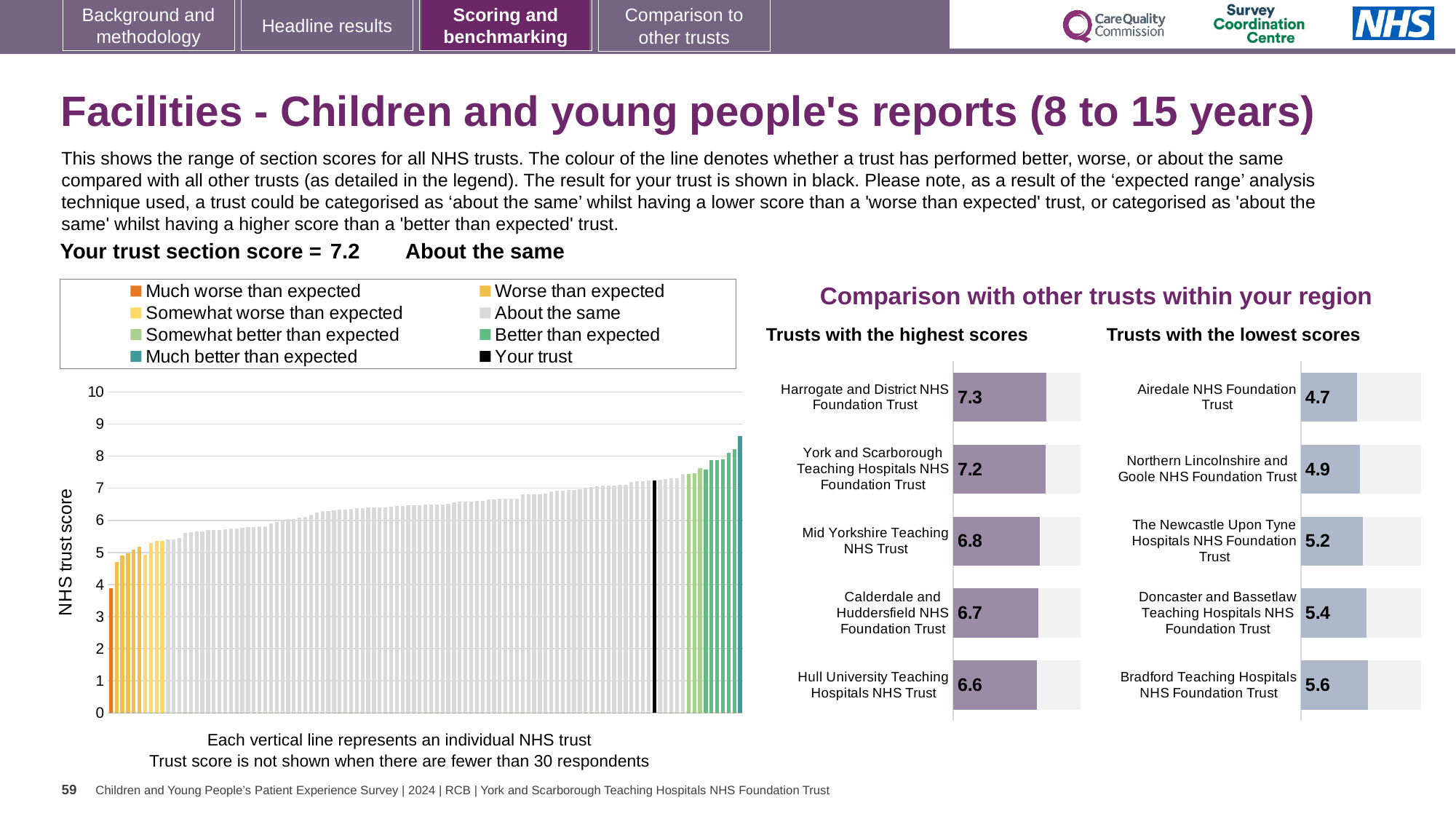
In the 'Trusts with the highest scores' chart, what is the score for Harrogate and District NHS Foundation Trust? 7.3 In the 'Trusts with the lowest scores' chart, what is the score for Airedale NHS Foundation Trust? 4.7 In the large chart on the left showing the range of section scores, do the bar values rise or fall from left to right? rise In the 'Trusts with the lowest scores' chart, what is the score for Doncaster and Bassetlaw Teaching Hospitals NHS Foundation Trust? 5.4 In the 'Trusts with the highest scores' chart, which trust has the lowest score? Hull University Teaching Hospitals NHS Trust In the 'Trusts with the highest scores' chart, what is the score for Mid Yorkshire Teaching NHS Trust? 6.8 In the 'Trusts with the highest scores' chart, what is the difference between the scores of Harrogate and District NHS Foundation Trust and Hull University Teaching Hospitals NHS Trust? 0.7 How many trusts are shown in the 'Trusts with the lowest scores' chart? 5 Which has a higher score: Northern Lincolnshire and Goole NHS Foundation Trust in the 'Trusts with the lowest scores' chart, or Calderdale and Huddersfield NHS Foundation Trust in the 'Trusts with the highest scores' chart? Calderdale and Huddersfield NHS Foundation Trust In the 'Trusts with the lowest scores' chart, what is the difference between the scores of Bradford Teaching Hospitals NHS Foundation Trust and Airedale NHS Foundation Trust? 0.9 In the large chart on the left showing the range of section scores, is the value of the tallest bar greater or less than 8? greater In the 'Trusts with the lowest scores' chart, which trust has the highest score? Bradford Teaching Hospitals NHS Foundation Trust